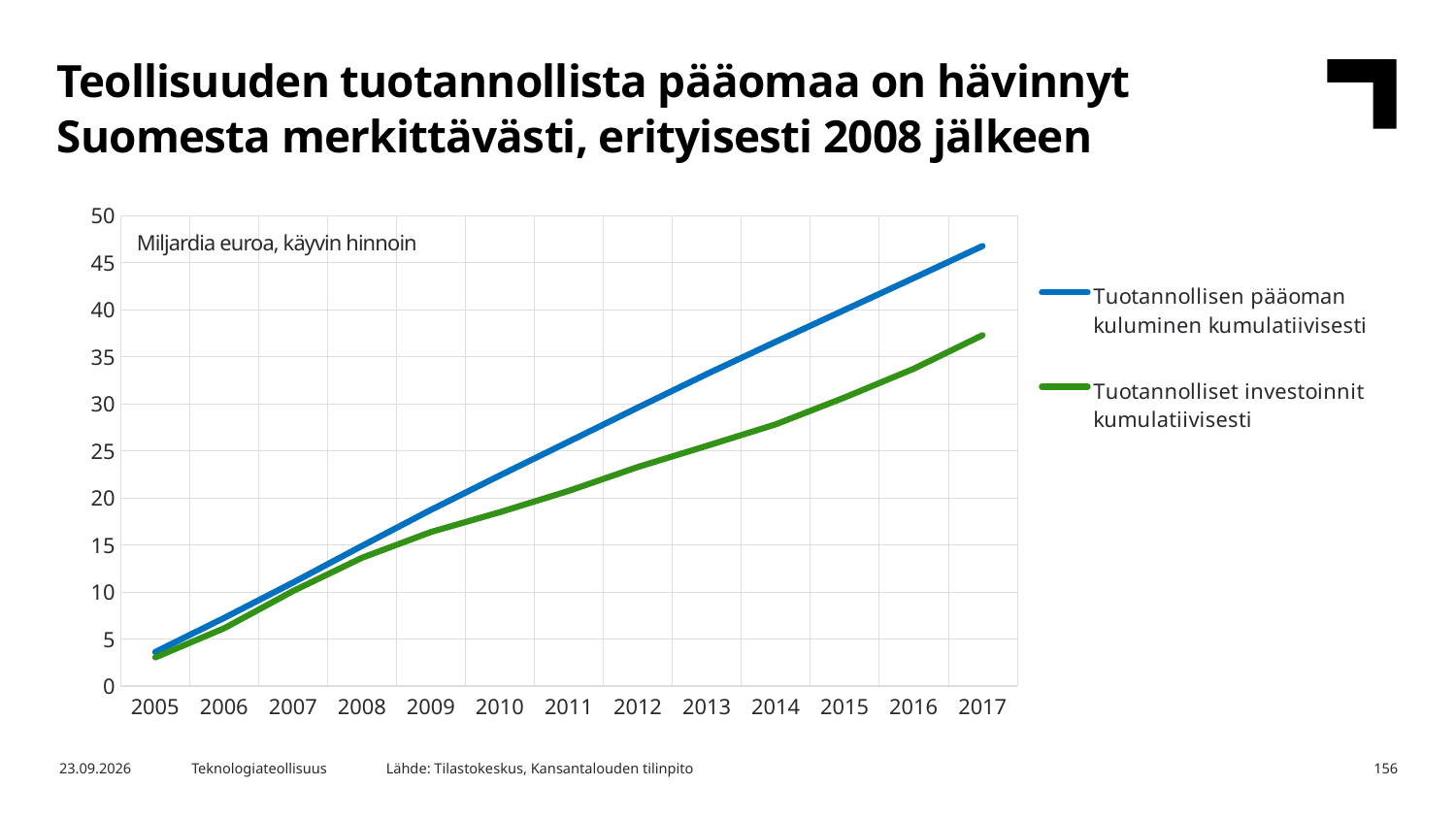
What unit is stated in the label inside the chart area? Miljardia euroa, käyvin hinnoin Is the value for 'Tuotannolliset investoinnit kumulatiivisesti' in 2017 greater or less than 35? greater How many years are shown on the x axis? 13 Do the values of the 'Tuotannollisen pääoman kuluminen kumulatiivisesti' series rise or fall from 2005 to 2017? rise Is the value for 'Tuotannollisen pääoman kuluminen kumulatiivisesti' in 2005 greater or less than 5? less Is the value for 'Tuotannollisen pääoman kuluminen kumulatiivisesti' in 2017 greater or less than 45? greater What kind of chart is shown on the slide? line chart In 2017, which series has the larger value: 'Tuotannollisen pääoman kuluminen kumulatiivisesti' or 'Tuotannolliset investoinnit kumulatiivisesti'? Tuotannollisen pääoman kuluminen kumulatiivisesti How many series does the legend list? 2 Which colour is used for the 'Tuotannolliset investoinnit kumulatiivisesti' line? green